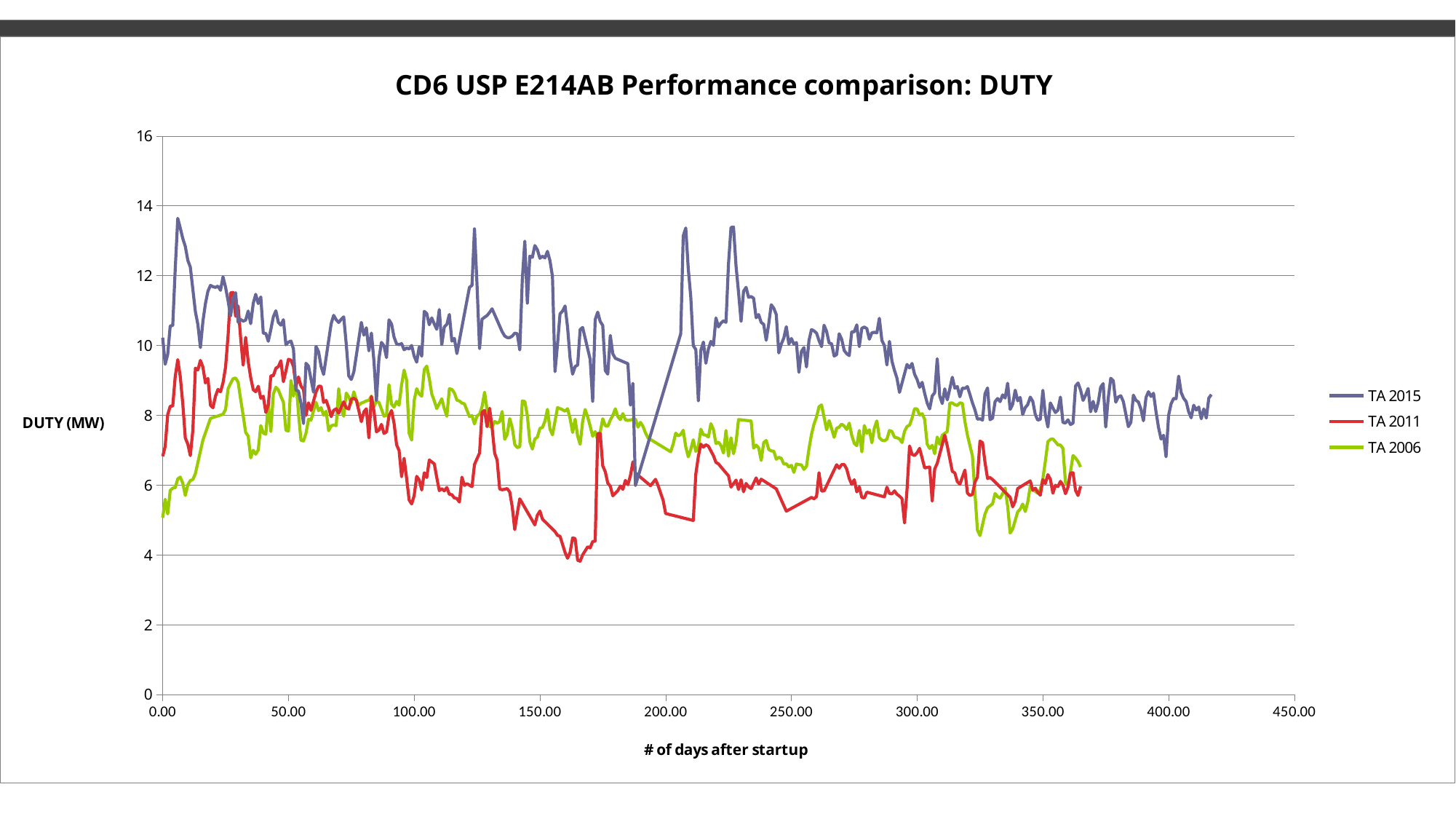
At around day 150, which series has the larger value, TA 2006 or TA 2011? TA 2006 Is the value for TA 2006 at day 0 greater or less than 6? less What is the label on the vertical axis? DUTY (MW) Which series reaches the highest duty value on the chart? TA 2015 Is the peak value of the TA 2015 series greater or less than 12? greater What kind of chart is shown on the slide? Line chart How many series does the legend list? 3 Is the value for TA 2011 around day 160 greater or less than 6? less Which series drops to the lowest duty value on the chart? TA 2011 Does the TA 2015 series generally rise or fall as the number of days after startup increases? fall At around day 100, which series has the larger value, TA 2015 or TA 2011? TA 2015 What is the title of the chart? CD6 USP E214AB Performance comparison: DUTY